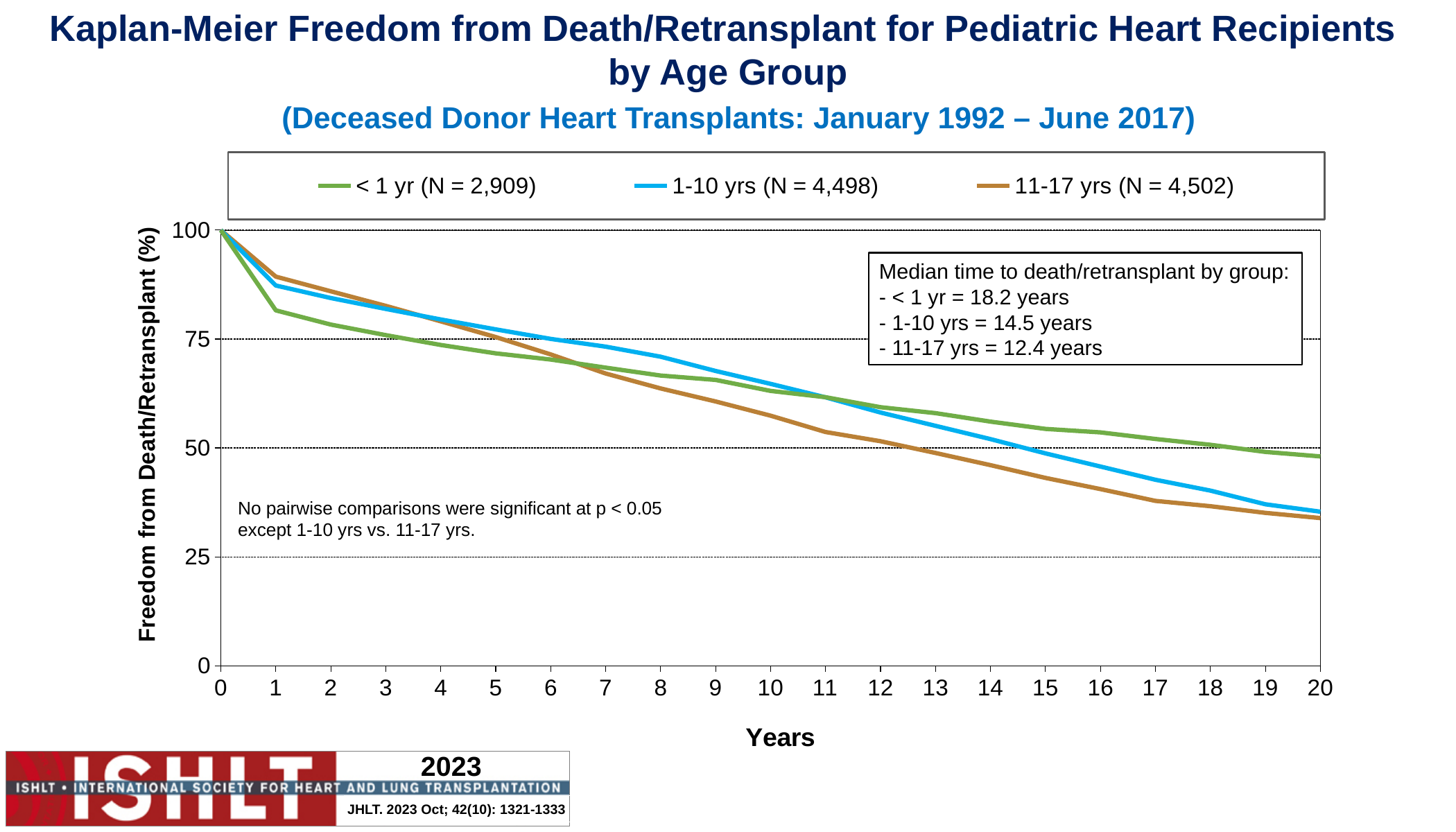
What is the freedom from death/retransplant value for the < 1 yr group at year 0? 100 At year 20, which group has the highest freedom from death/retransplant? < 1 yr What kind of chart is shown on the slide? Line chart Is the value for the 11-17 yrs group at year 15 greater or less than 50? less At year 1, which group has the lowest freedom from death/retransplant? < 1 yr Do the values for the 1-10 yrs group rise or fall as the years increase? Fall According to the legend, what is the N for the 1-10 yrs group? 4,498 Is the value for the 11-17 yrs group at year 10 greater or less than 50? greater How many series does the legend list? 3 Is the value for the 1-10 yrs group at year 20 greater or less than 50? less At year 20, which group has the higher value: < 1 yr or 1-10 yrs? < 1 yr